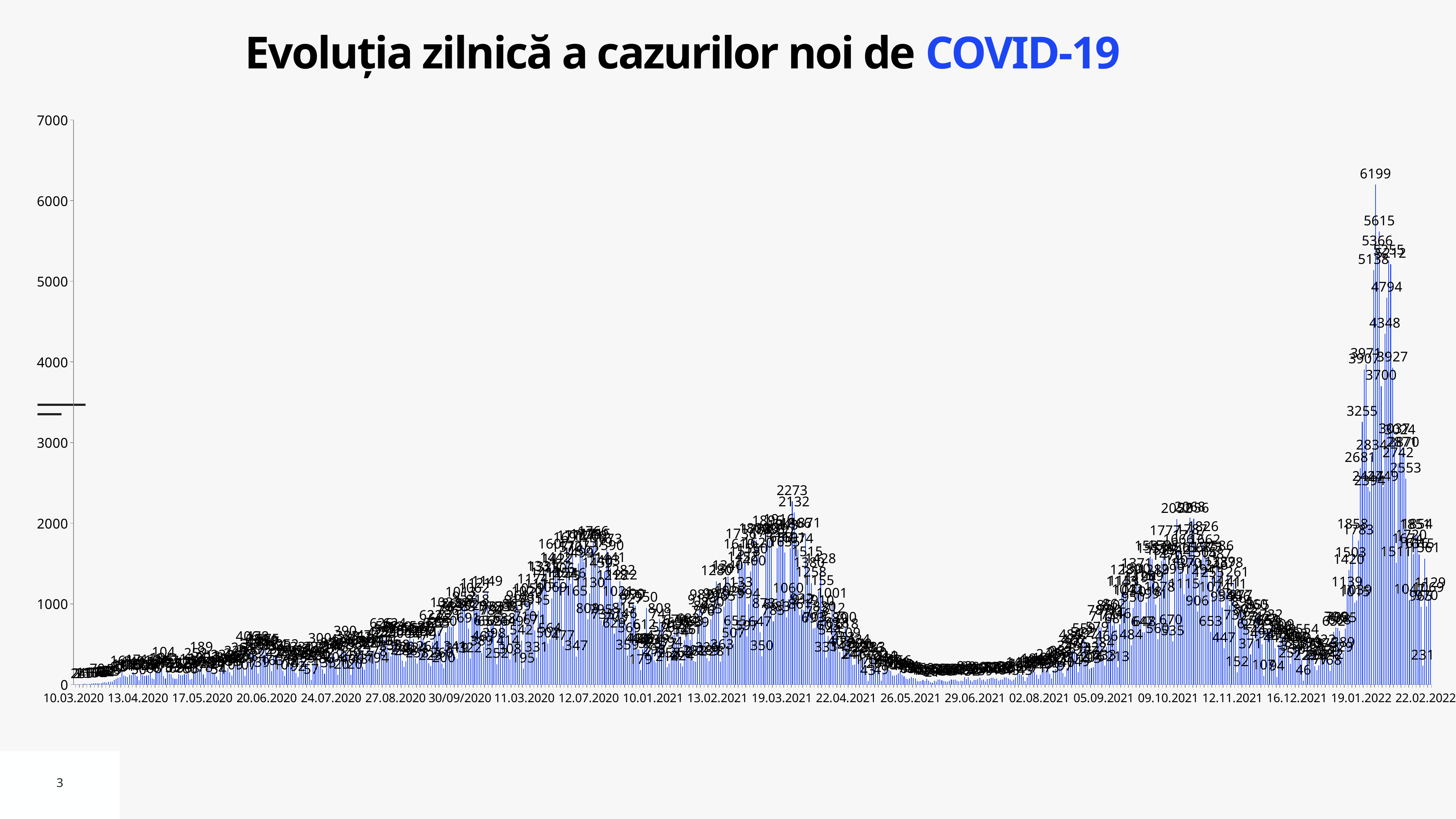
Do the daily values rise or fall from 19.01.2022 toward the 6199 peak? rise What is the title of the chart on the slide? Evoluția zilnică a cazurilor noi de COVID-19 Which is larger: the value labelled 2273 or the value labelled 2132 near 19.03.2021? 2273 What kind of chart is shown on the slide? bar chart Which is larger: the peak value of 6199 in early 2022 or the peak value of 2273 in March 2021? 6199 What is the first date shown on the x axis of the chart? 10.03.2020 What is the difference between the highest labelled value (6199) and the second highest labelled value (5615)? 584 Is the value labelled 4794 in the early 2022 wave greater or less than 4000? greater What is the highest daily value labelled on the chart? 6199 Is the highest bar on the chart greater or less than 6000? greater Is the peak value labelled 2273 around 19.03.2021 greater or less than 3000? less